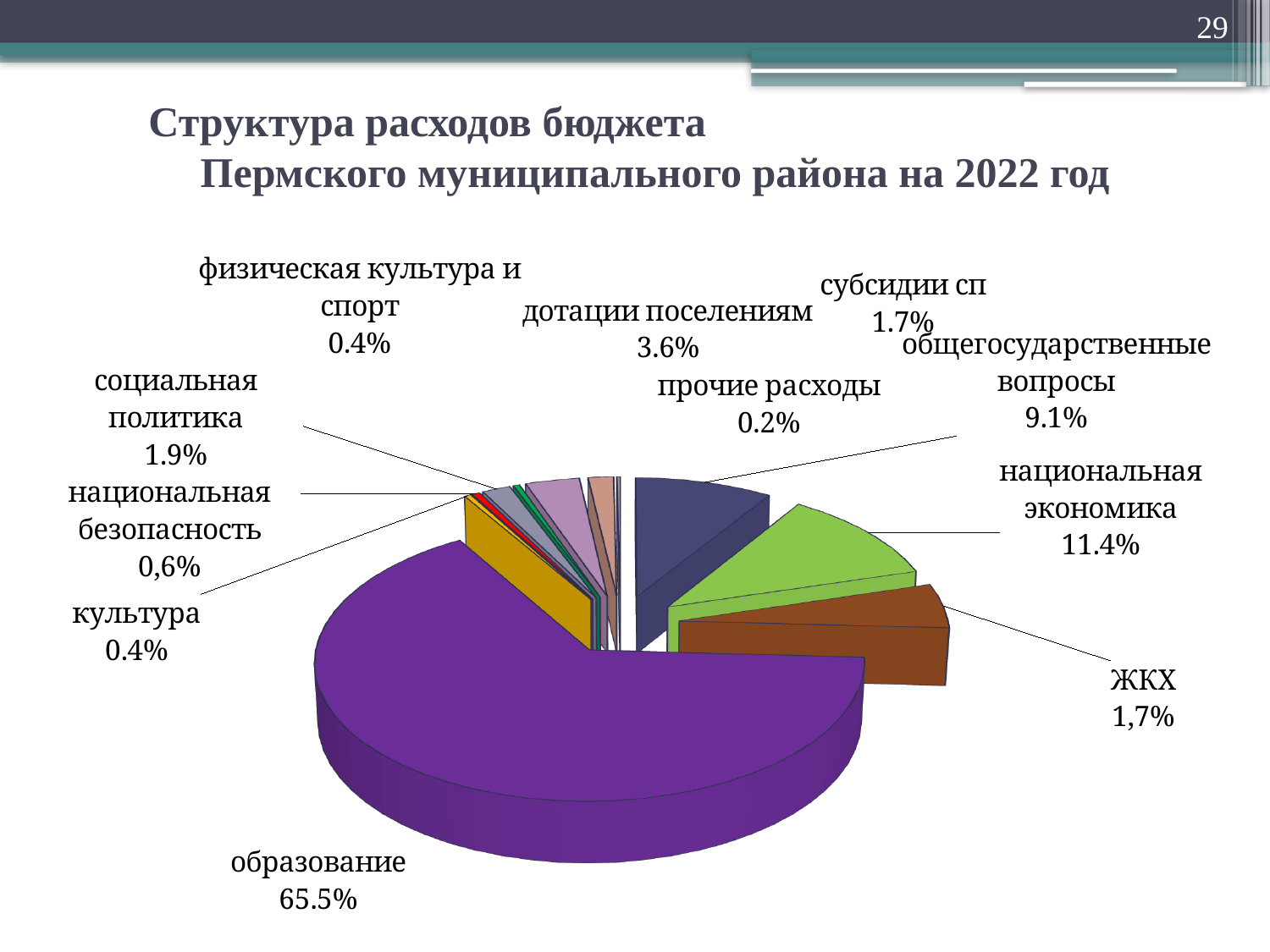
Which is larger: дотации поселениям or социальная политика? дотации поселениям What is the difference between the shares of национальная экономика and общегосударственные вопросы? 2.3% Which category has the smallest share of the pie? прочие расходы What is the difference between the shares of образование and национальная экономика? 54.1% How many categories are shown in the pie chart? 11 What percentage is shown for дотации поселениям? 3.6% What share of the budget expenditure goes to образование? 65.5% Which category has the largest share of the pie? образование What is the value shown for национальная экономика? 11.4% What type of chart is shown on the slide? Pie chart What is the title of the chart on the slide? Структура расходов бюджета Пермского муниципального района на 2022 год What is the value for ЖКХ? 1,7%